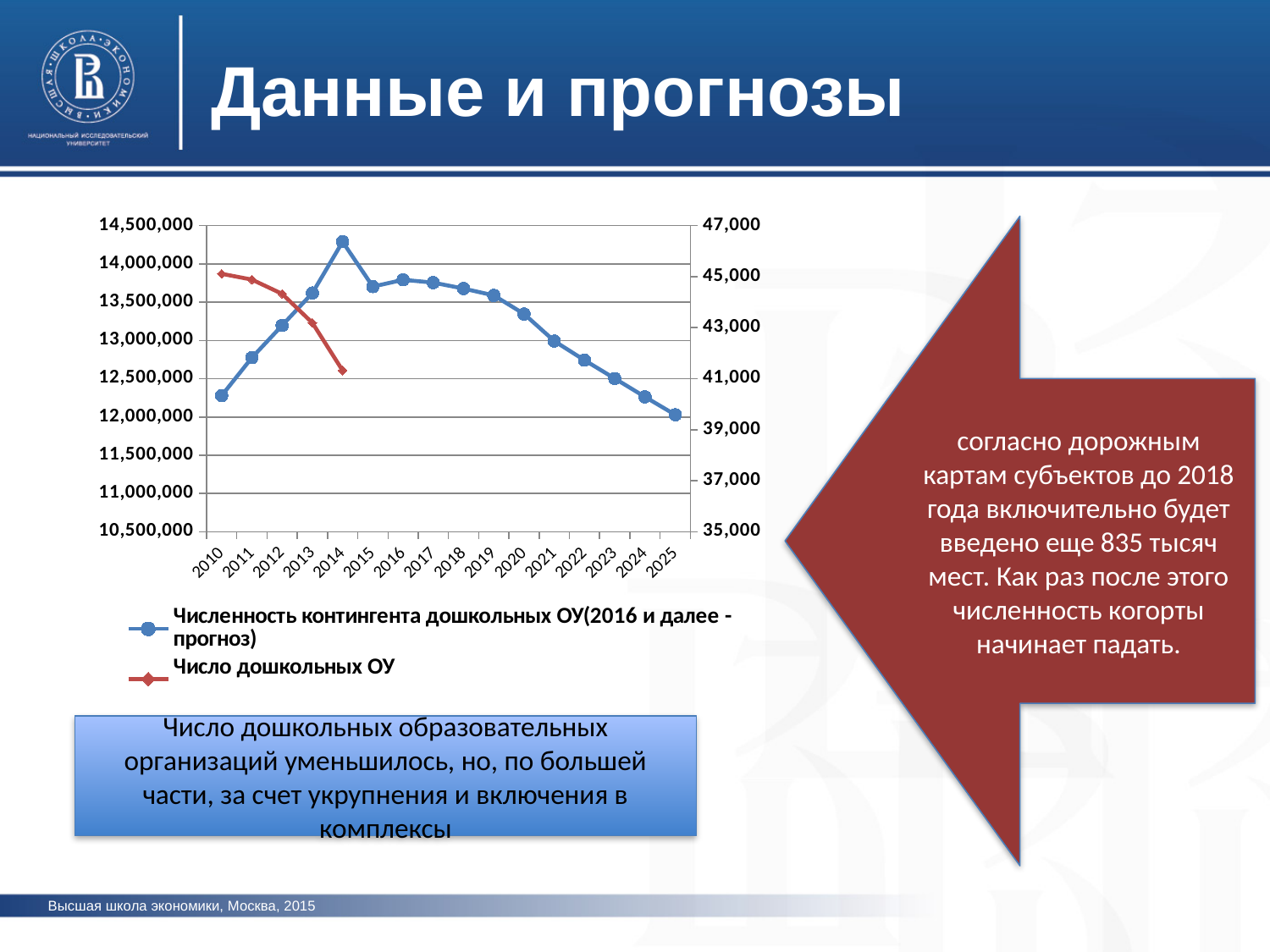
Is the value of 'Численность контингента дошкольных ОУ' in 2020 greater or less than 13,000,000? greater Is the value of 'Численность контингента дошкольных ОУ' in 2025 greater or less than 12,500,000? less Is the value of 'Число дошкольных ОУ' in 2014 greater or less than 43,000? less What kind of chart is shown on the slide? line chart In which year does the series 'Численность контингента дошкольных ОУ' reach its highest value? 2014 How many years are shown on the x axis of the chart? 16 In which year is the series 'Число дошкольных ОУ' at its lowest? 2014 Does the series 'Число дошкольных ОУ' rise or fall from 2010 to 2014? fall In which year does the series 'Численность контингента дошкольных ОУ' reach its lowest value? 2025 How many series does the chart legend list? 2 Which is larger for 'Численность контингента дошкольных ОУ': the value in 2016 or the value in 2023? 2016